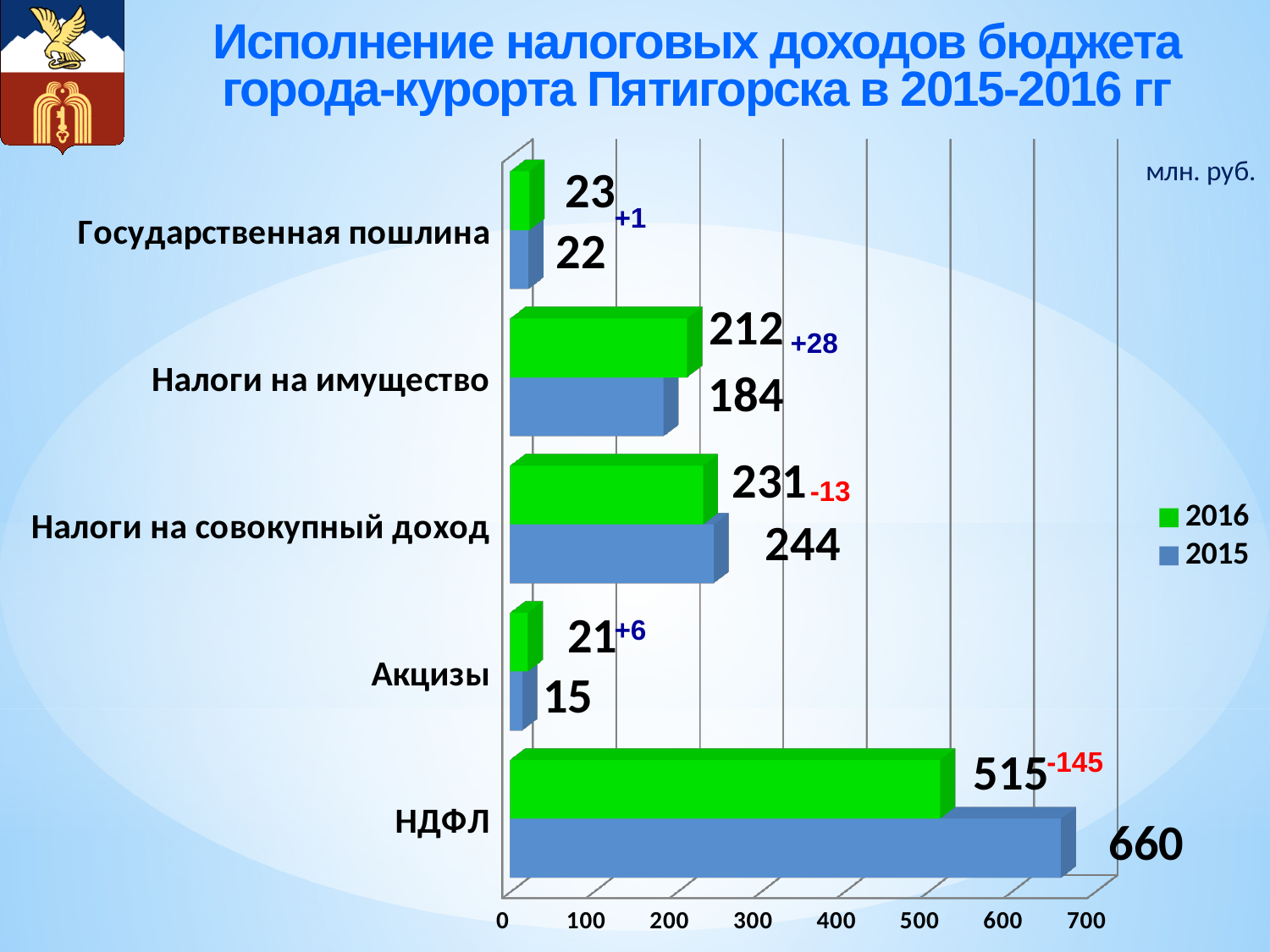
Which is larger for Налоги на имущество: the 2016 value or the 2015 value? 2016 Which category has the lowest value in 2016? Акцизы How many categories are shown on the chart? 5 What is the difference between the 2015 and 2016 values for Налоги на совокупный доход? 13 What unit is indicated for the values on the chart? млн. руб. What was the value for НДФЛ in 2015? 660 What was the value for НДФЛ in 2016? 515 How many series does the legend list? 2 What was the value for Налоги на имущество in 2016? 212 What was the value for Акцизы in 2015? 15 Which category has the highest value in 2015? НДФЛ What kind of chart is shown on the slide? Bar chart